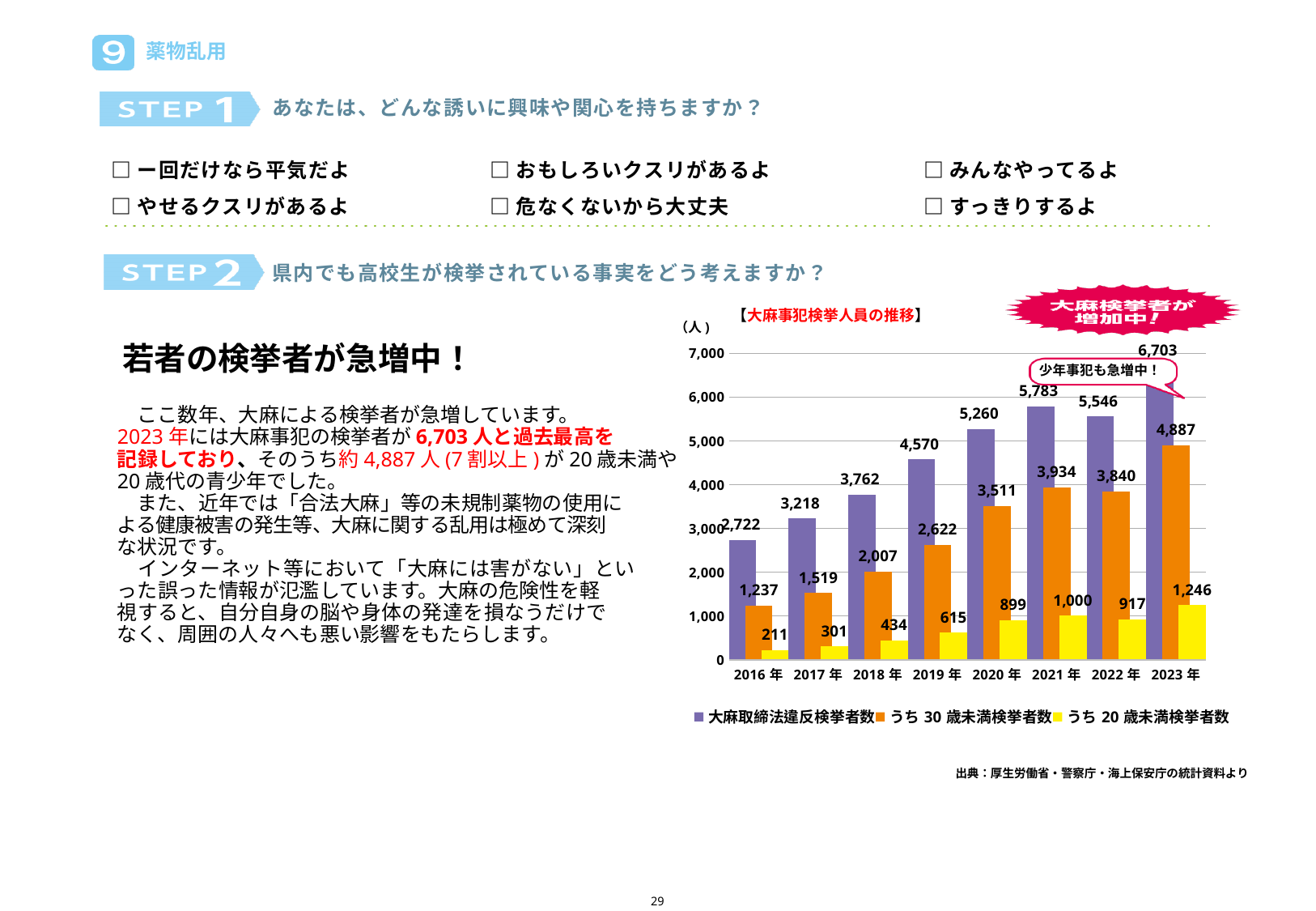
これはどの種類のグラフですか？ 棒グラフ 凡例にはいくつの系列が示されていますか？ 3 2020年のうち30歳未満検挙者数はいくつですか？ 3,511 2023年と2022年の大麻取締法違反検挙者数の差はいくつですか？ 1,157 うち20歳未満検挙者数が最も少ない年はどれですか？ 2016年 2018年の大麻取締法違反検挙者数は4,000より多いですか、少ないですか？ 少ない 大麻取締法違反検挙者数が最も多い年はどれですか？ 2023年 2016年から2021年にかけて、うち20歳未満検挙者数は増加していますか、減少していますか？ 増加 このグラフには何年分のデータが示されていますか？ 8 2023年の大麻取締法違反検挙者数はいくつですか？ 6,703 2021年と2022年では、うち30歳未満検挙者数はどちらが多いですか？ 2021年 2019年のうち20歳未満検挙者数はいくつですか？ 615